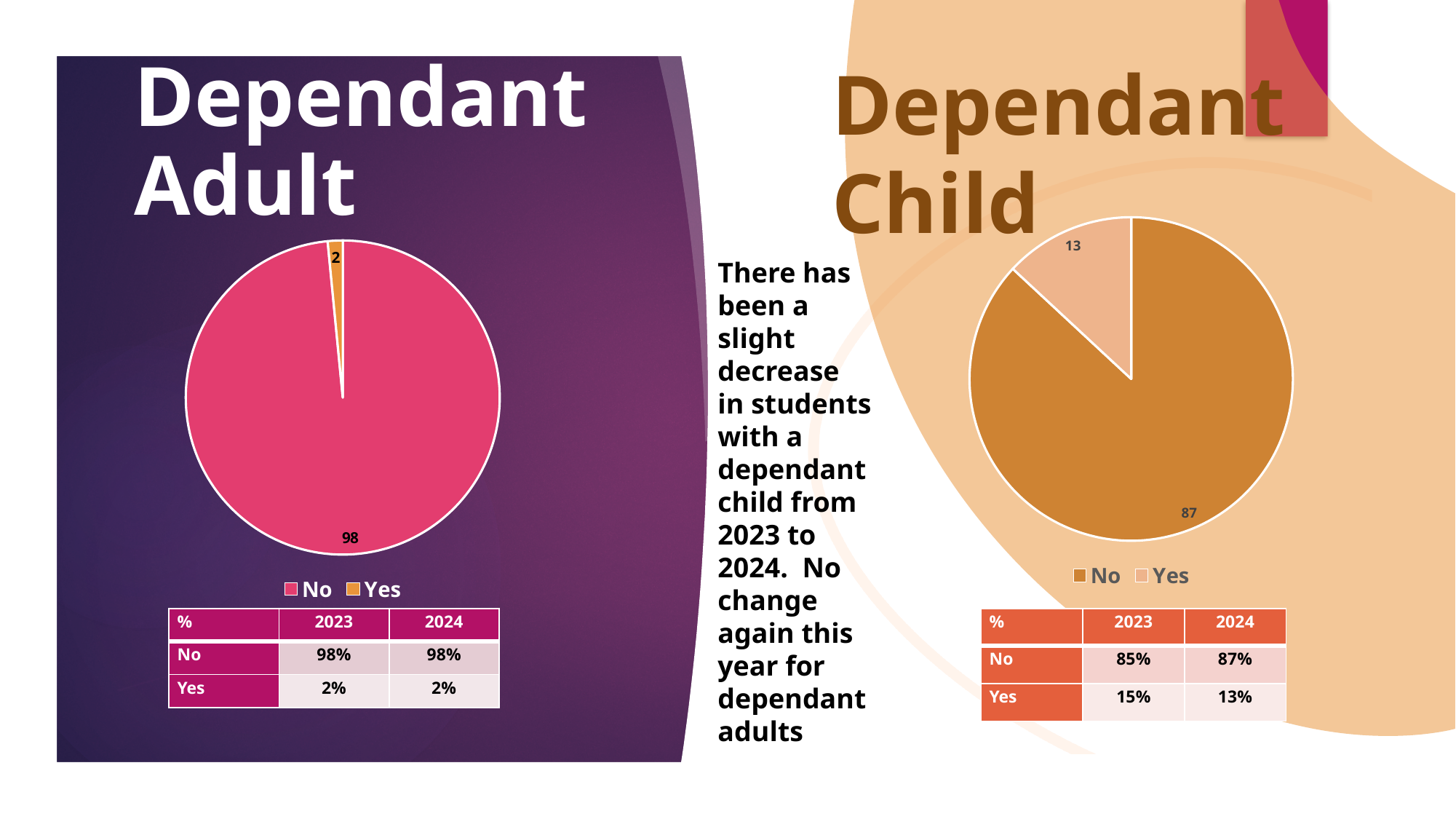
In the Dependant Child pie chart, what is the value for Yes? 13 In the Dependant Adult pie chart, what is the value for Yes? 2 In the Dependant Child pie chart, what is the difference between the No and Yes values? 74 In the Dependant Child pie chart, which category has the largest slice? No In the Dependant Adult pie chart, which category has the smallest slice? Yes In the Dependant Adult pie chart, what is the difference between the No and Yes values? 96 In the Dependant Adult pie chart, what is the value for No? 98 How many slices does the Dependant Child pie chart have? 2 How many entries does the legend of the Dependant Adult chart list? 2 Is the Yes slice larger in the Dependant Adult chart or the Dependant Child chart? Dependant Child In the Dependant Child pie chart, what is the value for No? 87 What type of chart is used for Dependant Adult? Pie chart